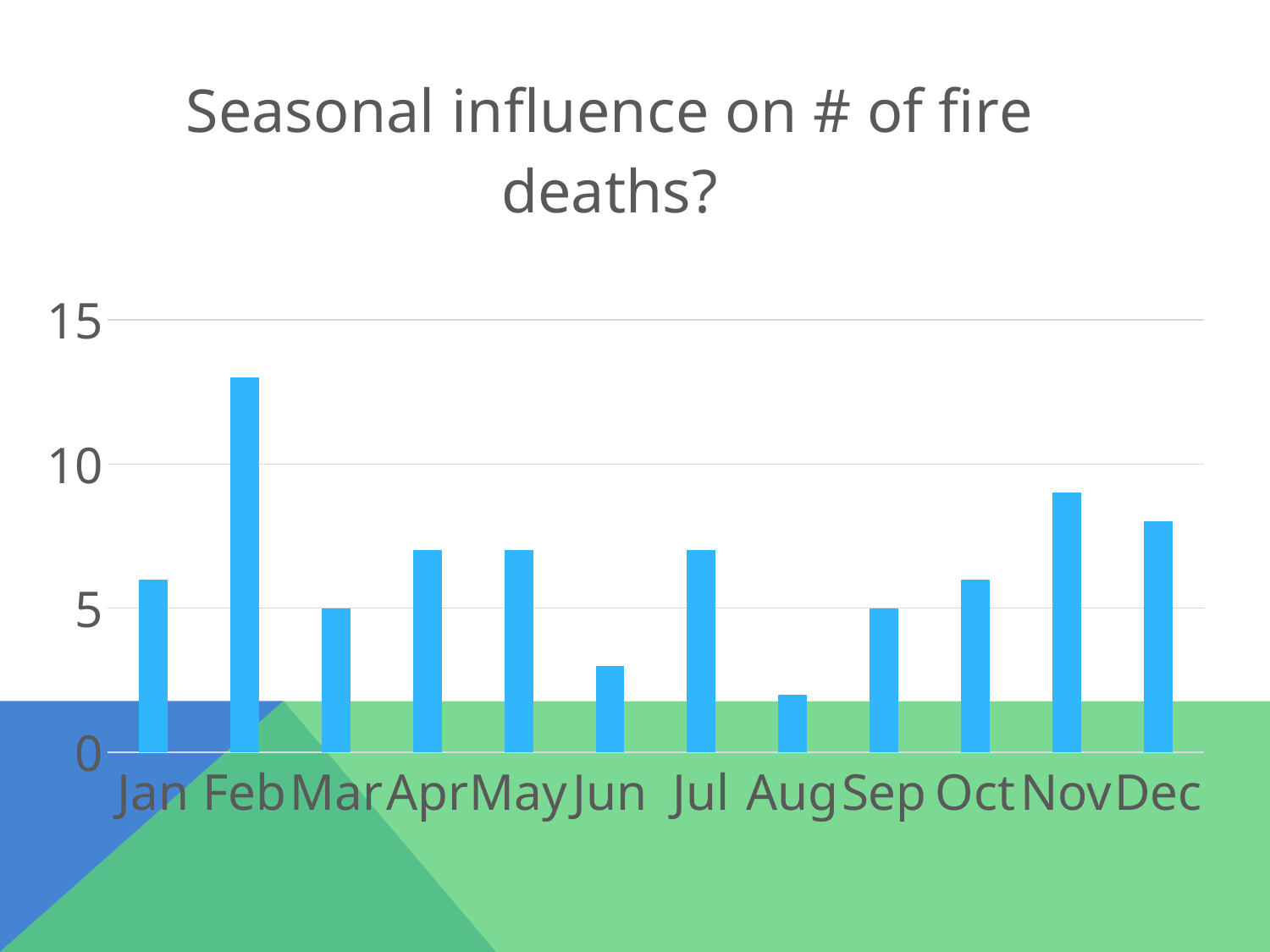
Which month has the lowest number of fire deaths? Aug Is the value for Feb greater or less than 10? greater What is the title of the chart? Seasonal influence on # of fire deaths? Is the value for Dec greater or less than 5? greater Which month has a higher value, Jun or Aug? Jun Is the value for Nov greater or less than 10? less How many months are shown on the x axis of the chart? 12 Which month has the highest number of fire deaths? Feb Which month has a higher value, Feb or Nov? Feb What type of chart is shown on the slide? Bar chart What is the value for Mar? 5